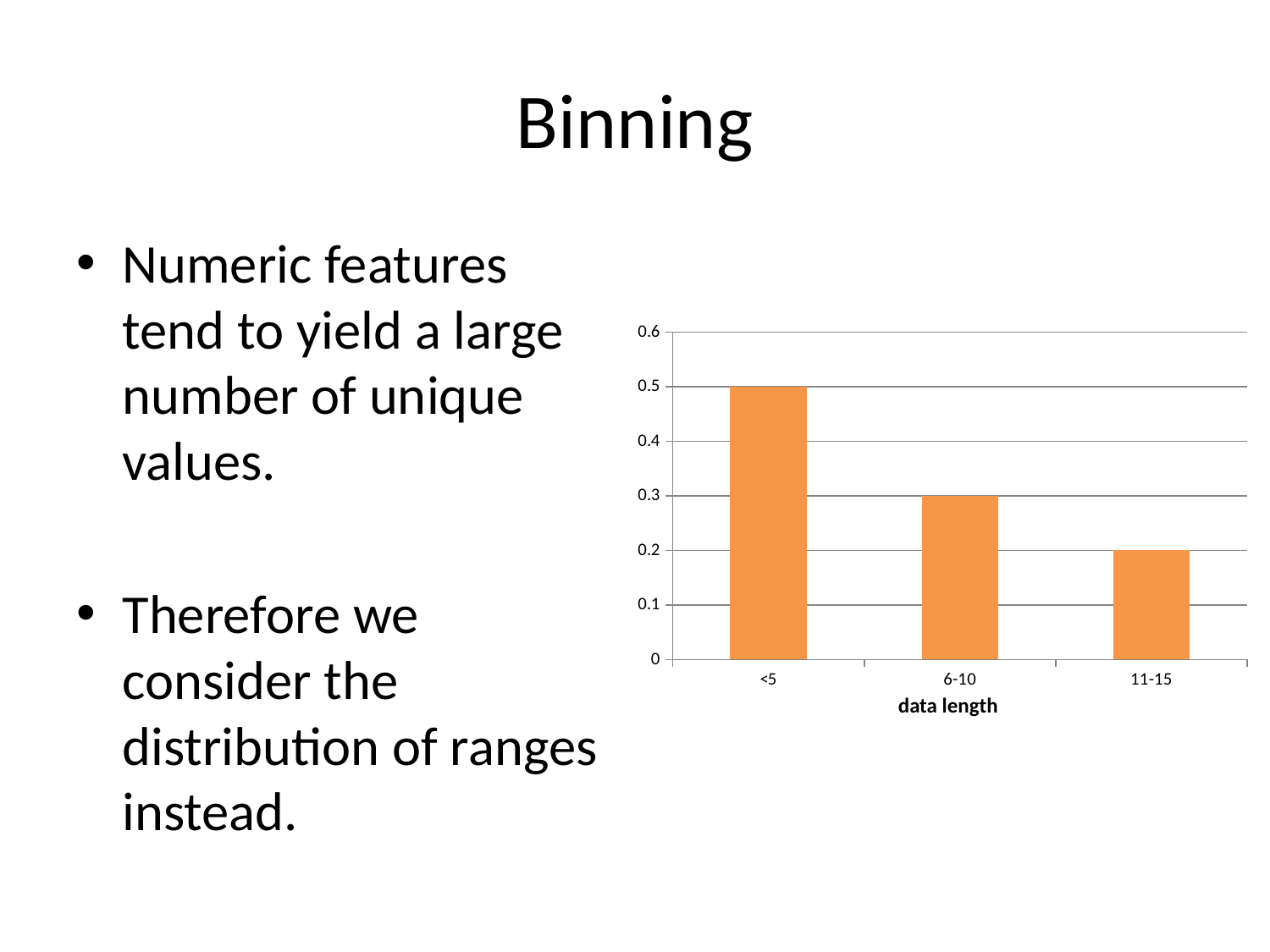
What is the value for the 11-15 bin? 0.2 How many bins are shown on the x axis? 3 Which data length bin has the highest value? <5 Which is larger, the value for <5 or the value for 11-15? <5 Do the values rise or fall as data length increases along the x axis? fall What is the difference between the values for <5 and 6-10? 0.2 Is the value for 6-10 greater or less than 0.4? less What is the difference between the values for 6-10 and 11-15? 0.1 Which data length bin has the lowest value? 11-15 What kind of chart is shown on the slide? bar chart What is the value for the 6-10 bin? 0.3 What is the value for the <5 bin? 0.5